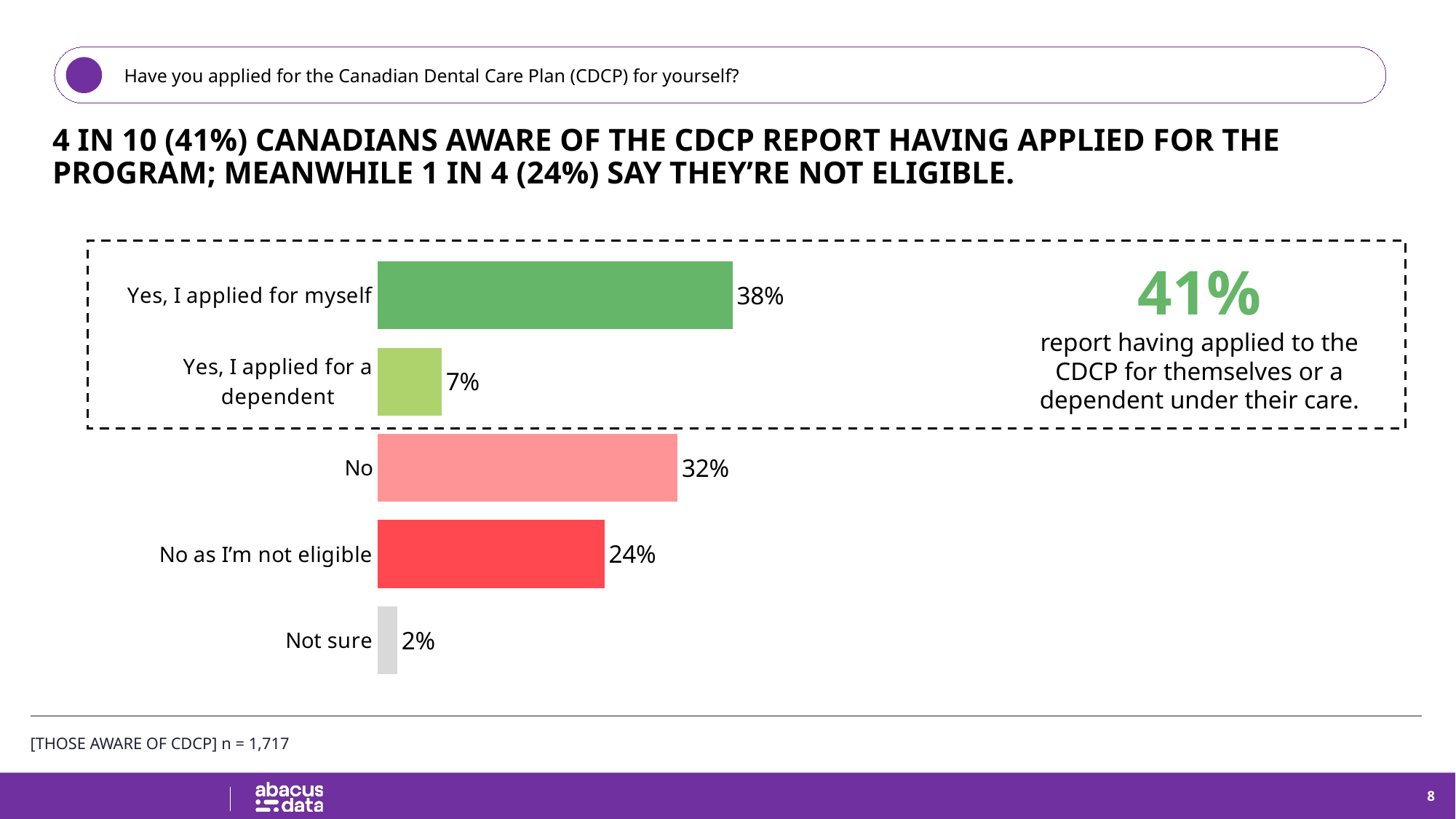
How many response categories are shown in the chart? 5 What is the difference between the "Yes, I applied for myself" and "No" values? 6 percentage points What percentage of respondents said "Yes, I applied for myself"? 38% What percentage of respondents said "Not sure"? 2% What percentage of respondents answered "No"? 32% What type of chart is shown on the slide? Bar chart Which response category has the highest value? Yes, I applied for myself What percentage of respondents said "No as I'm not eligible"? 24% Which is larger: the value for "No" or the value for "No as I'm not eligible"? No What is the combined total of the two "Yes" categories (applied for myself and applied for a dependent)? 45% Which response category has the lowest value? Not sure What percentage of respondents said "Yes, I applied for a dependent"? 7%